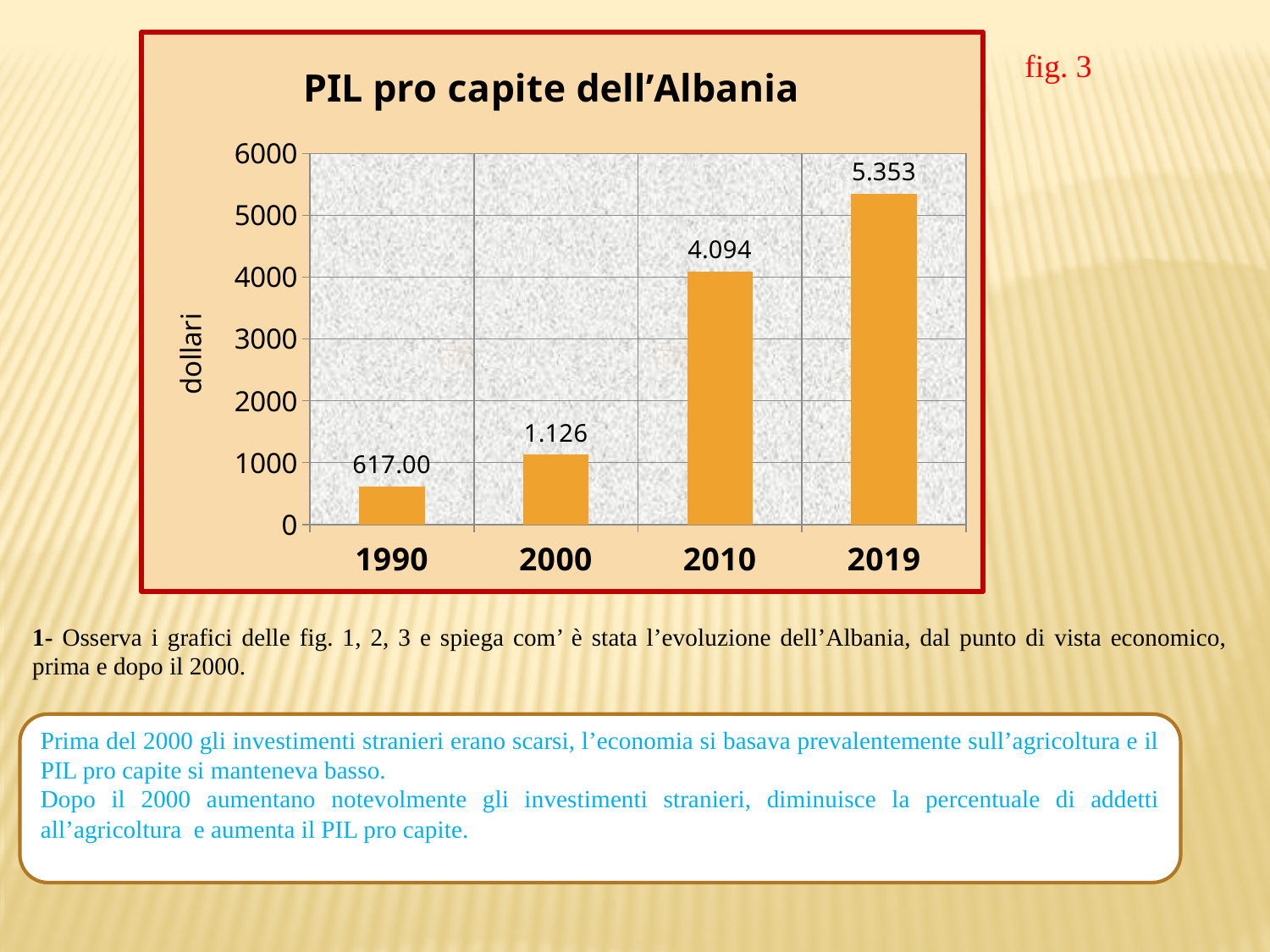
Which year has the lowest value in the chart? 1990 Which year has the highest value in the chart? 2019 What is the title of the chart? PIL pro capite dell'Albania What is the value for 2010 in the chart? 4.094 What is the value for 2000 in the chart? 1.126 Is the value for 2010 greater or less than 3000? greater Which is larger, the value for 2000 or the value for 2010? 2010 What kind of chart is shown on the slide? bar chart How many years are shown on the x axis of the chart? 4 Do the values rise or fall from 1990 to 2019? rise What is the value for 1990 in the chart? 617.00 What is the value for 2019 in the chart? 5.353